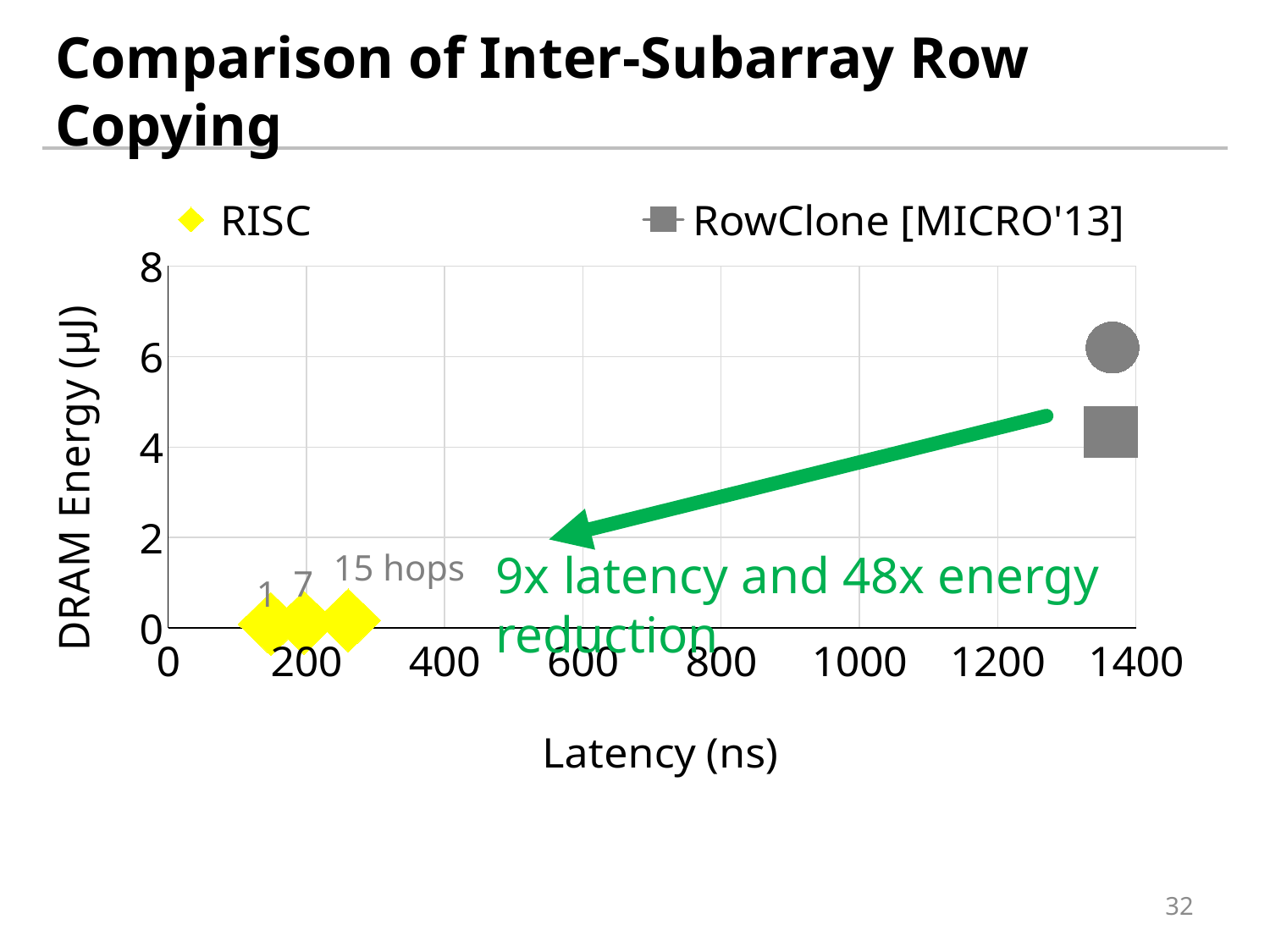
Is the DRAM energy for the RISC points greater or less than 2 µJ? less Is the latency for the RISC points greater or less than 400 ns? less How many series does the legend list? 2 Is the DRAM energy for the RowClone [MICRO'13] square marker greater or less than 2 µJ? greater What is the title of the x axis? Latency (ns) What reduction does the green annotation on the chart claim? 9x latency and 48x energy reduction How many RISC data points are plotted? 3 What kind of chart is shown on the slide? scatter chart Which series has the higher DRAM energy, RISC or RowClone [MICRO'13]? RowClone [MICRO'13] Which series has the lower latency, RISC or RowClone [MICRO'13]? RISC